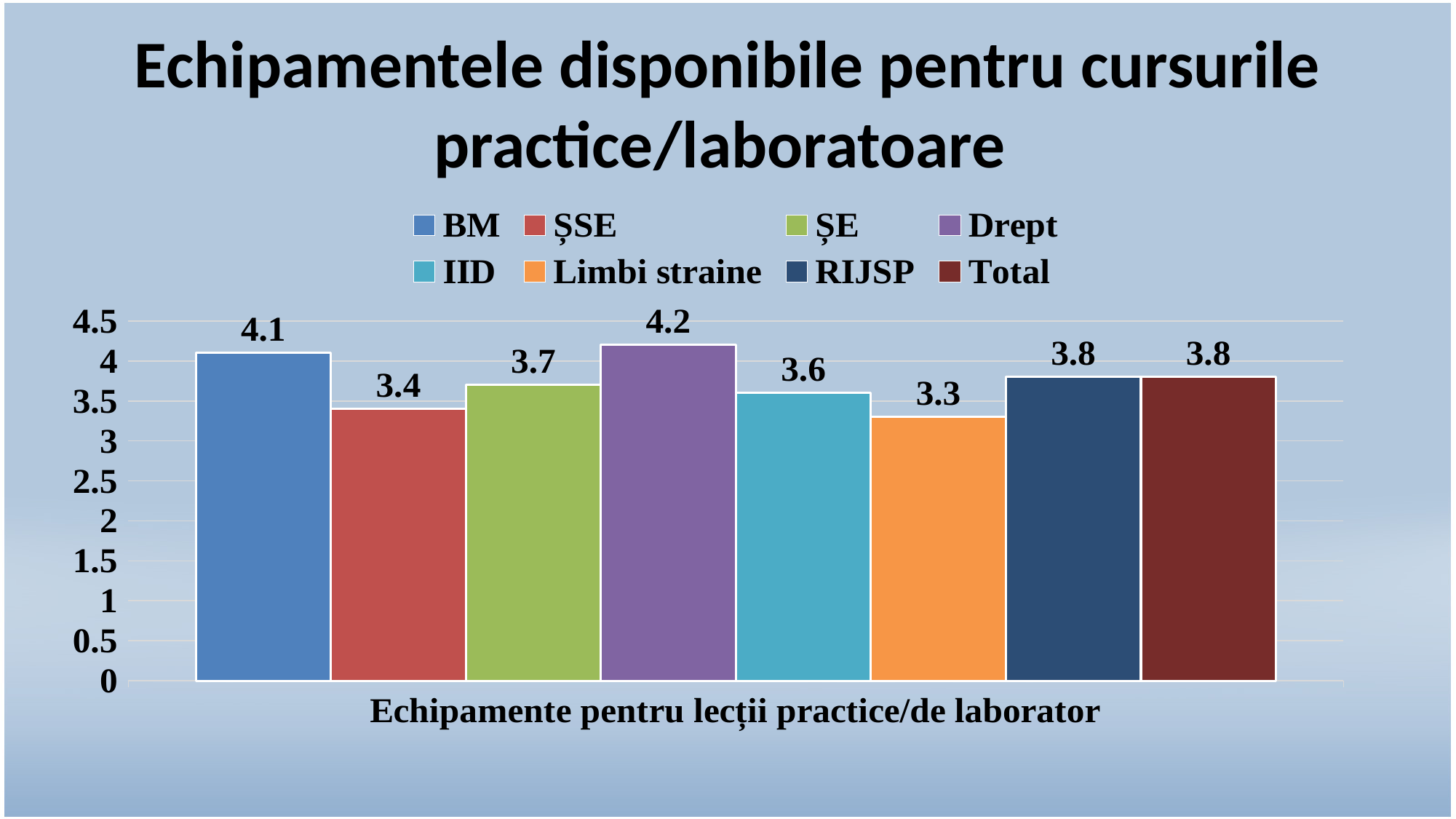
Which series has the highest value? Drept Which series has the lowest value? Limbi straine What is the value for Limbi straine? 3.3 What is the difference between the values for Drept and ȘSE? 0.8 How many series does the legend list? 8 Is the value for ȘSE greater or less than 3.5? less Which is larger, the value for ȘE or the value for IID? ȘE What is the value for Drept? 4.2 What is the label shown below the x axis of the chart? Echipamente pentru lecţii practice/de laborator What is the value for BM? 4.1 What is the value for Total? 3.8 What kind of chart is shown on the slide? bar chart